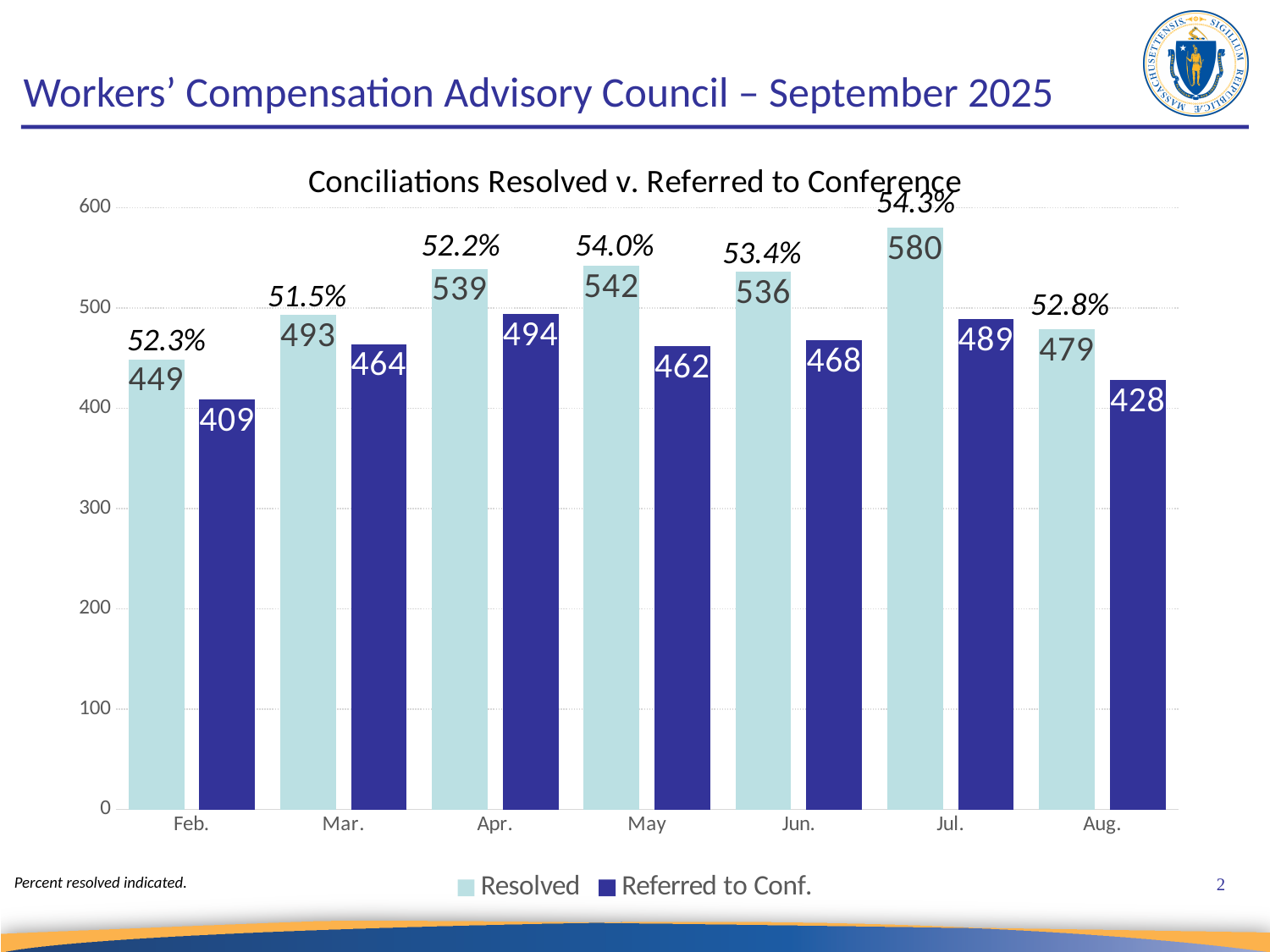
What is the title of the chart? Conciliations Resolved v. Referred to Conference What percent resolved is indicated for Apr.? 52.2% Which month has the highest Resolved value? Jul. How many months are shown on the x axis? 7 What is the Referred to Conf. value for Feb.? 409 Is the Referred to Conf. value for Aug. greater or less than 400? greater What is the difference between the Resolved and Referred to Conf. values for Jul.? 91 What is the Resolved value for Jul.? 580 Which month has the lowest Referred to Conf. value? Feb. Which is larger for May: the Resolved value or the Referred to Conf. value? Resolved What kind of chart is shown? Bar chart How many series does the legend list? 2